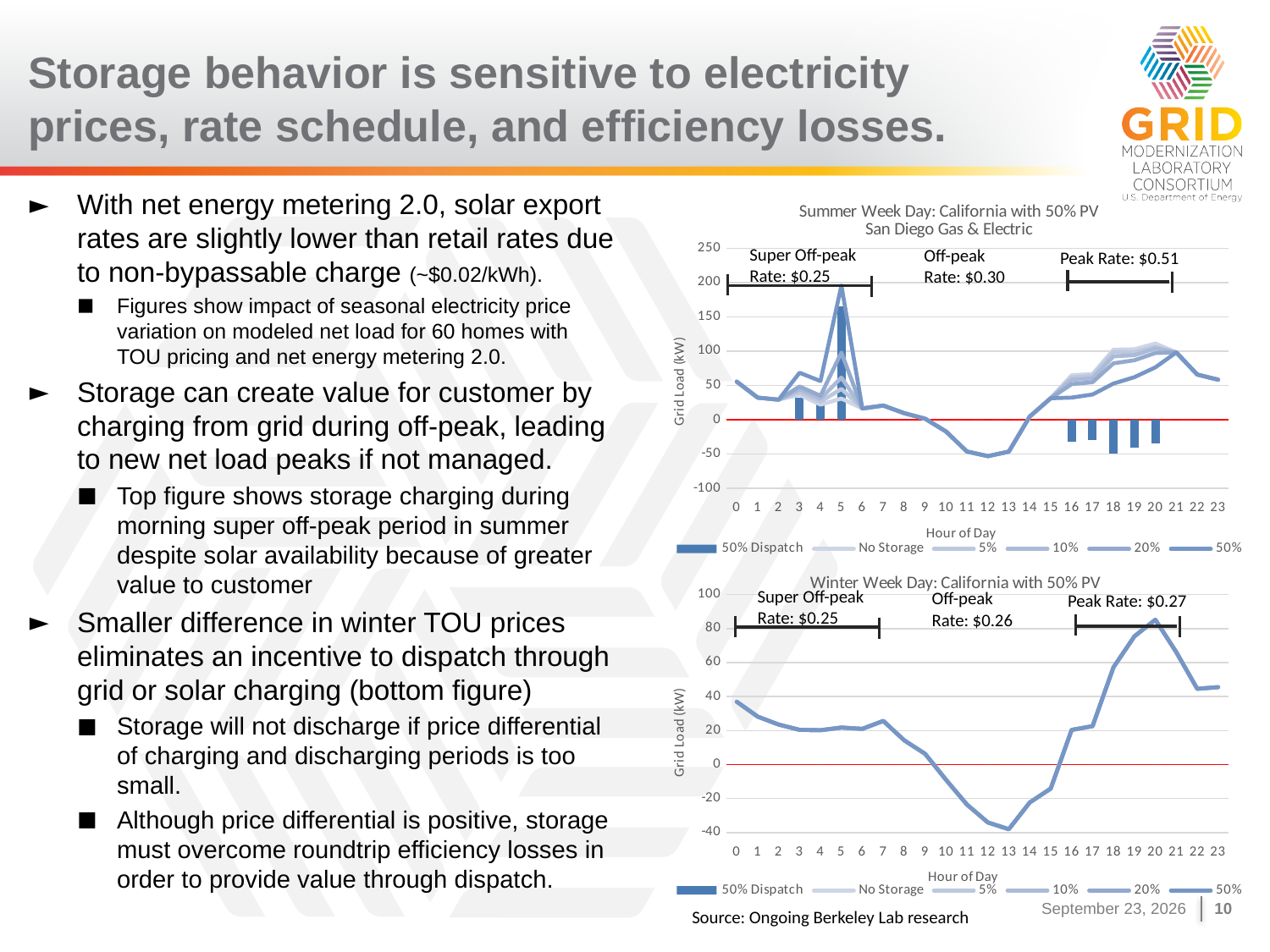
What kind of chart is the top chart, 'Summer Week Day: California with 50% PV'? Line chart (with bars for 50% Dispatch) In the bottom chart, 'Winter Week Day', is the grid load at hour 20 greater or less than 60 kW? greater In the top chart, 'Summer Week Day', is the grid load at hour 12 greater or less than 0 kW? less How many series does the legend of the bottom chart, 'Winter Week Day: California with 50% PV', list? 6 In the bottom chart, 'Winter Week Day', at which hour of the day does the grid load reach its highest value? 20 In the bottom chart, 'Winter Week Day', does the grid load rise or fall between hour 16 and hour 20? rise What peak rate is annotated on the top chart, 'Summer Week Day'? $0.51 In the bottom chart, 'Winter Week Day', at which hour of the day does the grid load reach its lowest value? 13 In the bottom chart, 'Winter Week Day', is the grid load at hour 13 greater or less than -20 kW? less How many hours of the day are plotted along the x axis of the top chart, 'Summer Week Day'? 24